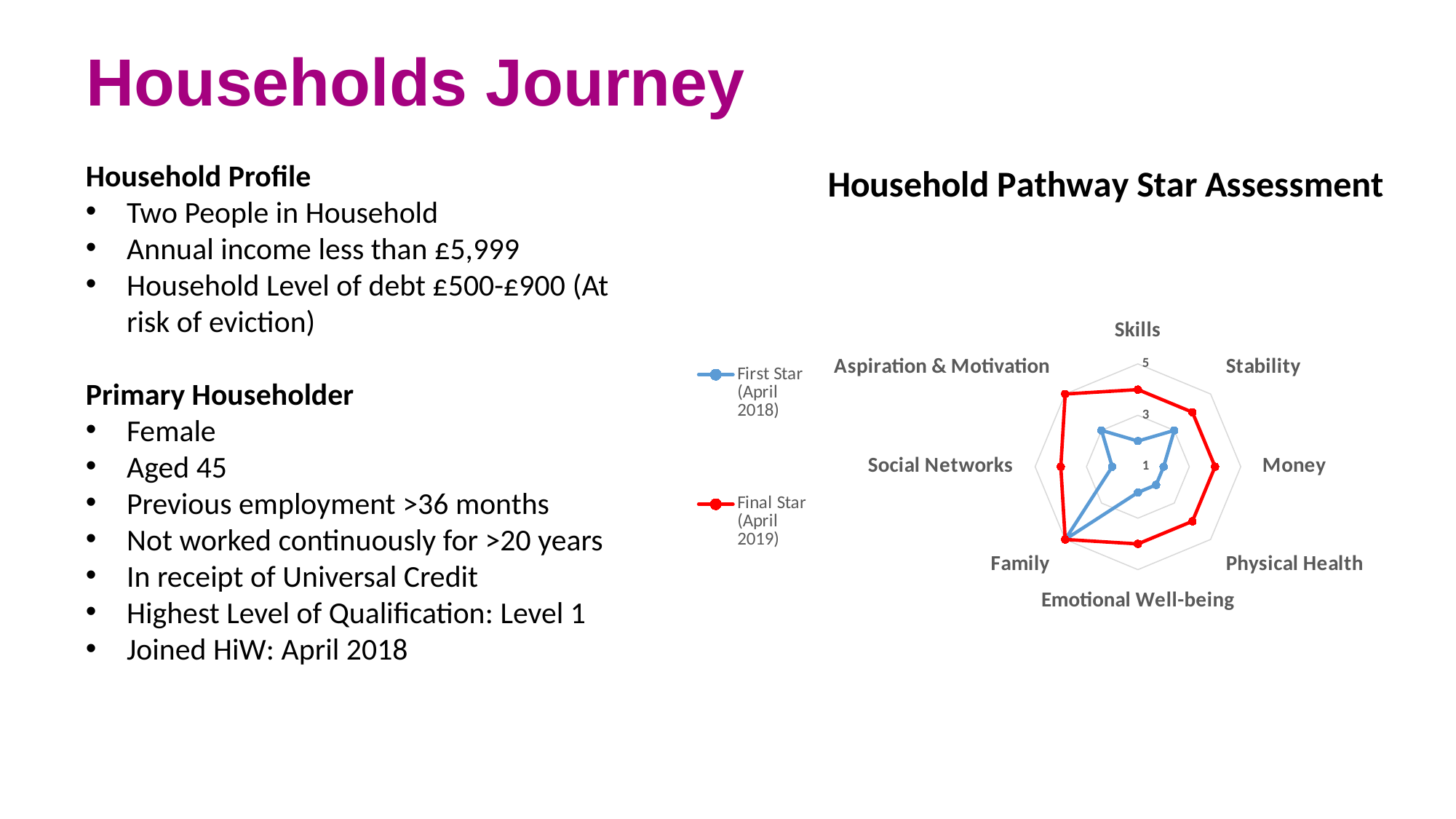
For Skills, which series has the larger value: First Star (April 2018) or Final Star (April 2019)? Final Star (April 2019) For Money, which series has the larger value: First Star (April 2018) or Final Star (April 2019)? Final Star (April 2019) Which category has the highest value for the First Star (April 2018) series? Family Is the Final Star (April 2019) value for Emotional Well-being greater or less than 3? greater What colour is the Final Star (April 2019) series in the chart? Red Is the First Star (April 2018) value for Skills greater or less than 3? less How many categories (axes) does the Household Pathway Star Assessment radar chart have? 8 Is the First Star (April 2018) value for Social Networks greater or less than 3? less How many series does the legend of the Household Pathway Star Assessment chart list? 2 What kind of chart is the Household Pathway Star Assessment? Radar chart What is the title of the chart on the slide? Household Pathway Star Assessment